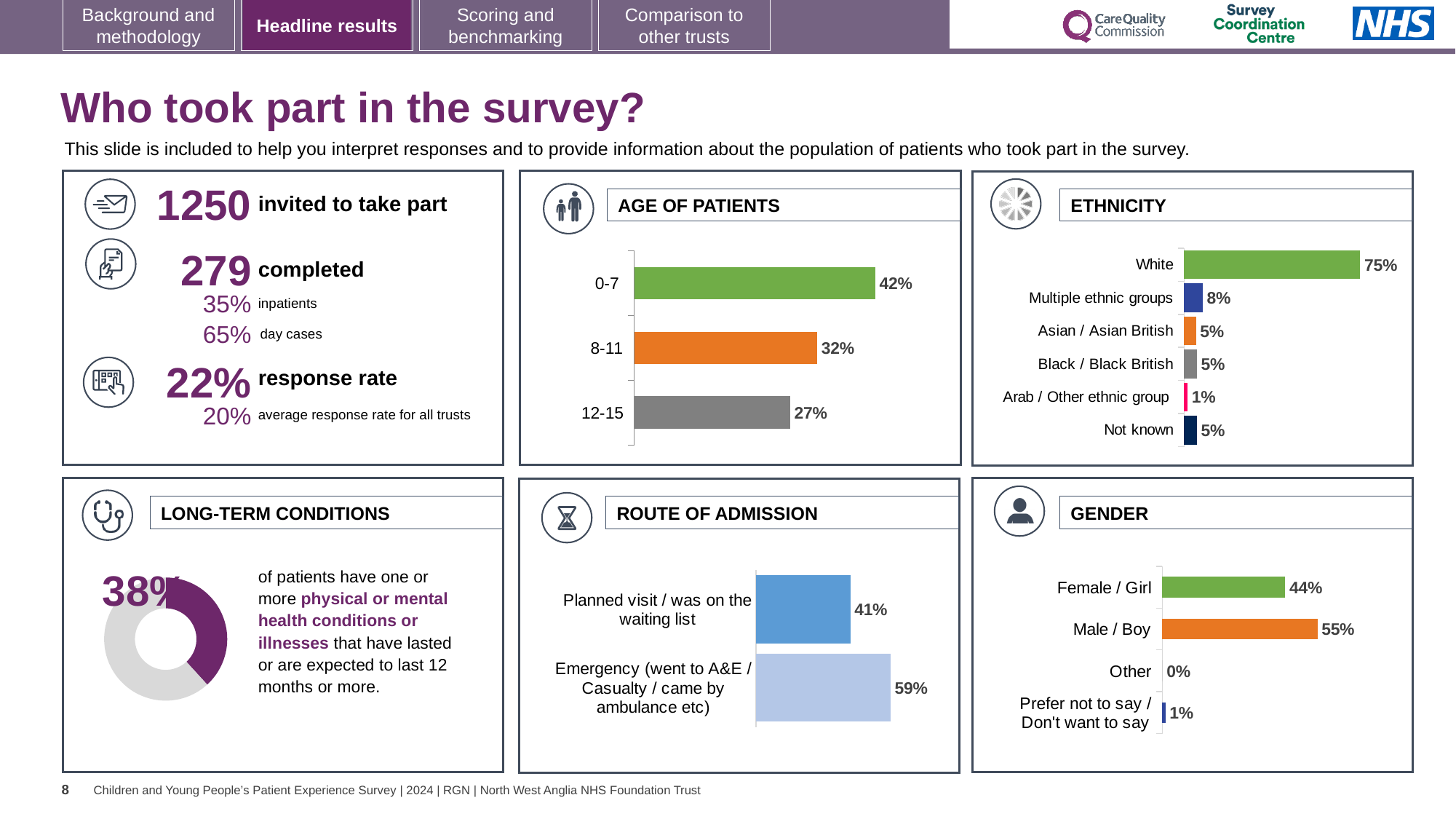
In the GENDER chart, what is the difference between Male / Boy and Female / Girl? 11% In the ETHNICITY chart, which category has the lowest value? Arab / Other ethnic group In the ROUTE OF ADMISSION chart, which is larger: Planned visit / was on the waiting list or Emergency? Emergency (went to A&E / Casualty / came by ambulance etc) In the LONG-TERM CONDITIONS chart, what share of patients have one or more long-term conditions? 38% What kind of chart is the LONG-TERM CONDITIONS chart? Donut chart In the AGE OF PATIENTS chart, what is the value for the 8-11 age group? 32% How many categories are shown in the ETHNICITY chart? 6 In the ETHNICITY chart, what is the value for Multiple ethnic groups? 8% In the AGE OF PATIENTS chart, which age group has the highest value? 0-7 In the ROUTE OF ADMISSION chart, what is the value for Emergency (went to A&E / Casualty / came by ambulance etc)? 59% In the GENDER chart, what is the value for Male / Boy? 55% In the AGE OF PATIENTS chart, what is the difference between the 0-7 and 12-15 values? 15%